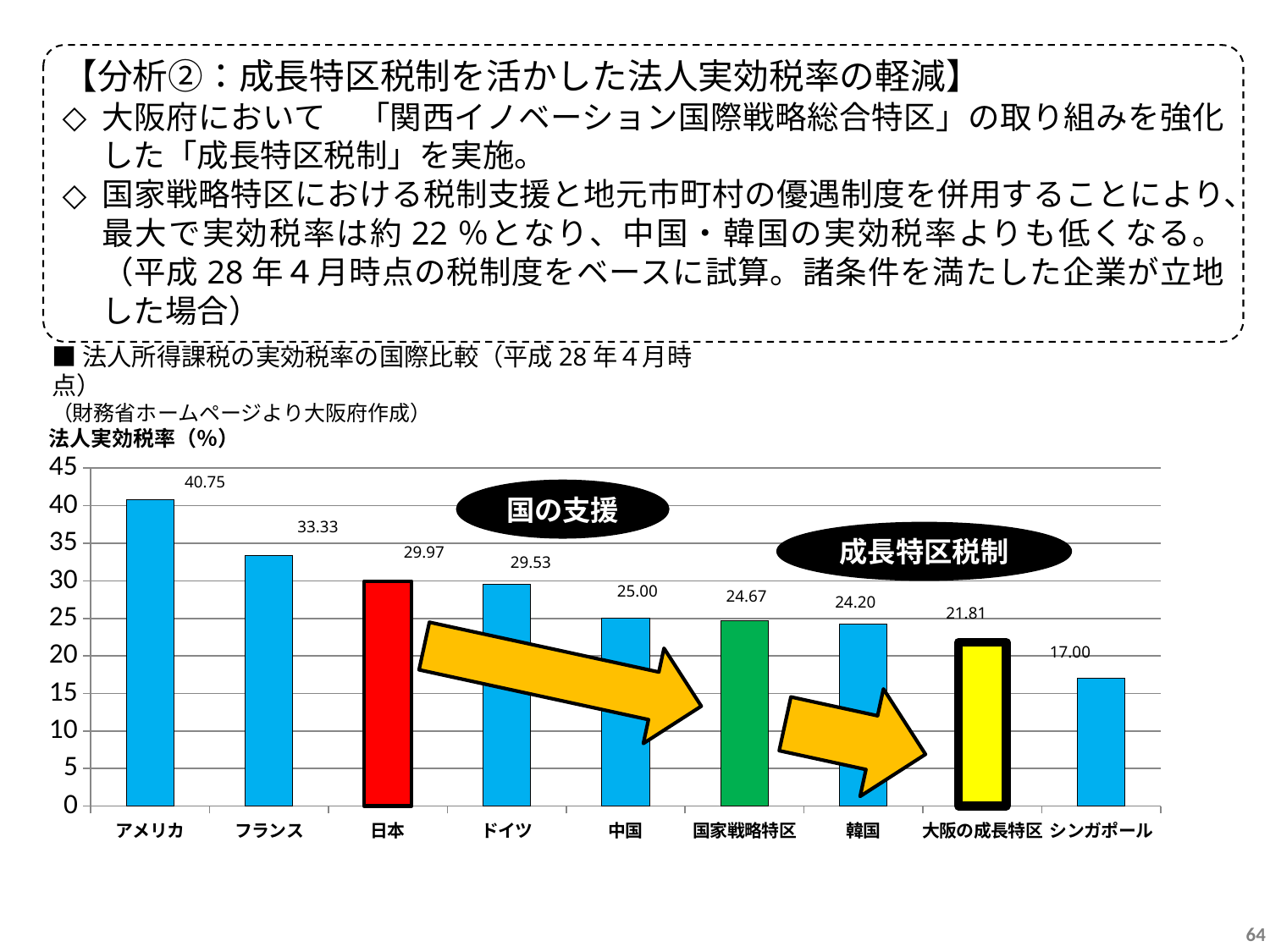
What is the value for アメリカ? 40.75 What colour is the bar for 日本? red How many categories are shown on the x axis? 9 Is the value for フランス greater or less than 30? greater What is the value for 大阪の成長特区? 21.81 Which is larger, the value for 中国 or the value for 韓国? 中国 What kind of chart is this? bar chart What is the difference between the values for 日本 and 大阪の成長特区? 8.16 Which category has the highest value? アメリカ What is the value for 国家戦略特区? 24.67 Do the values generally rise or fall from left to right along the x axis? fall Which category has the lowest value? シンガポール